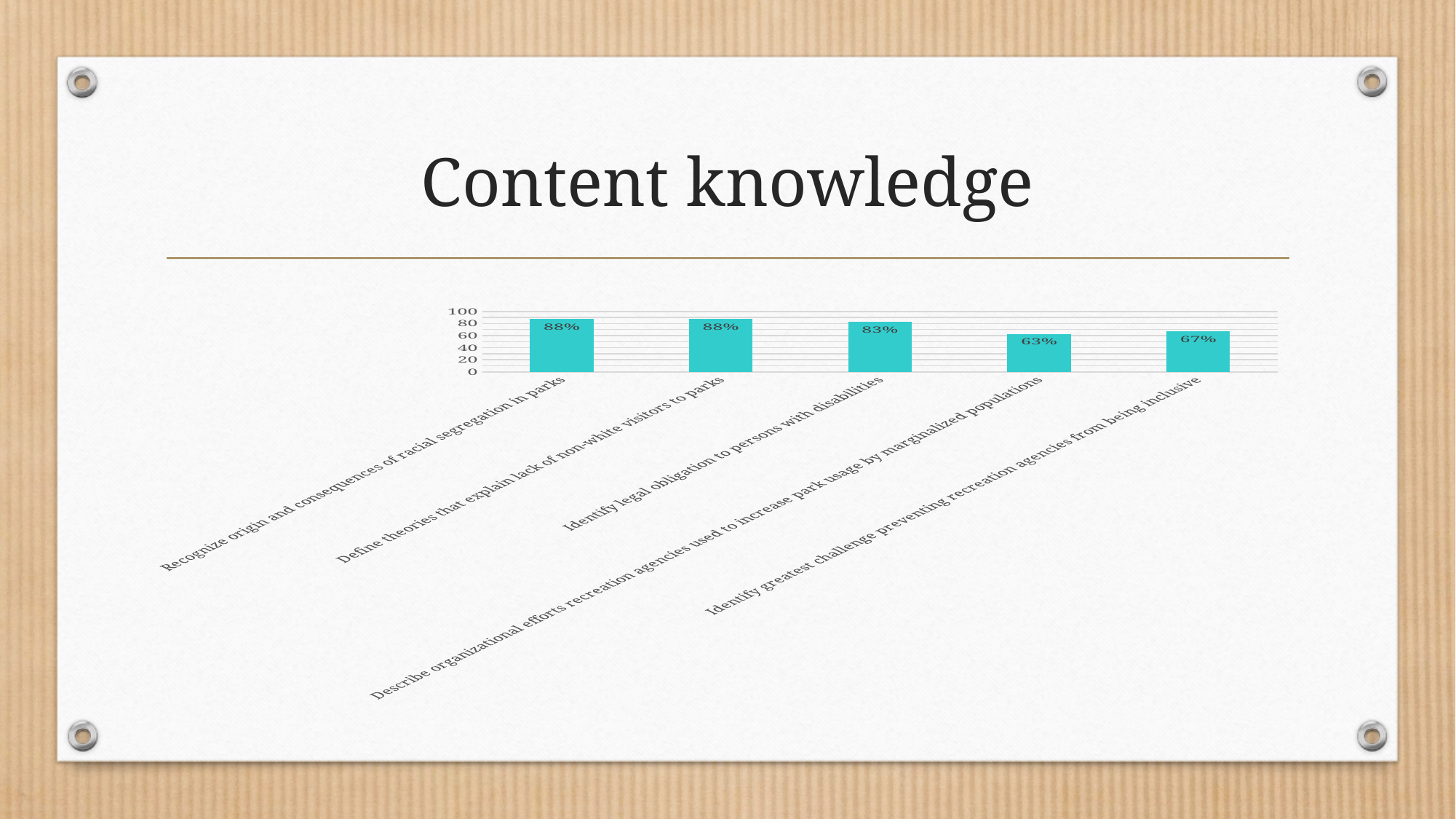
How many categories are shown in the chart? 5 What kind of chart is shown on the slide? Bar chart What is the title of the slide containing the chart? Content knowledge What is the value for "Identify greatest challenge preventing recreation agencies from being inclusive"? 67% Which is larger: the value for "Define theories that explain lack of non-white visitors to parks" or the value for "Identify greatest challenge preventing recreation agencies from being inclusive"? Define theories that explain lack of non-white visitors to parks What is the difference between the values for "Identify legal obligation to persons with disabilities" and "Describe organizational efforts recreation agencies used to increase park usage by marginalized populations"? 20% What is the value for "Recognize origin and consequences of racial segregation in parks"? 88% What is the value for "Identify legal obligation to persons with disabilities"? 83% What is the maximum value shown on the vertical axis? 100 Is the value for "Describe organizational efforts recreation agencies used to increase park usage by marginalized populations" greater or less than 80? less What is the value for "Describe organizational efforts recreation agencies used to increase park usage by marginalized populations"? 63% Which category has the lowest value? Describe organizational efforts recreation agencies used to increase park usage by marginalized populations